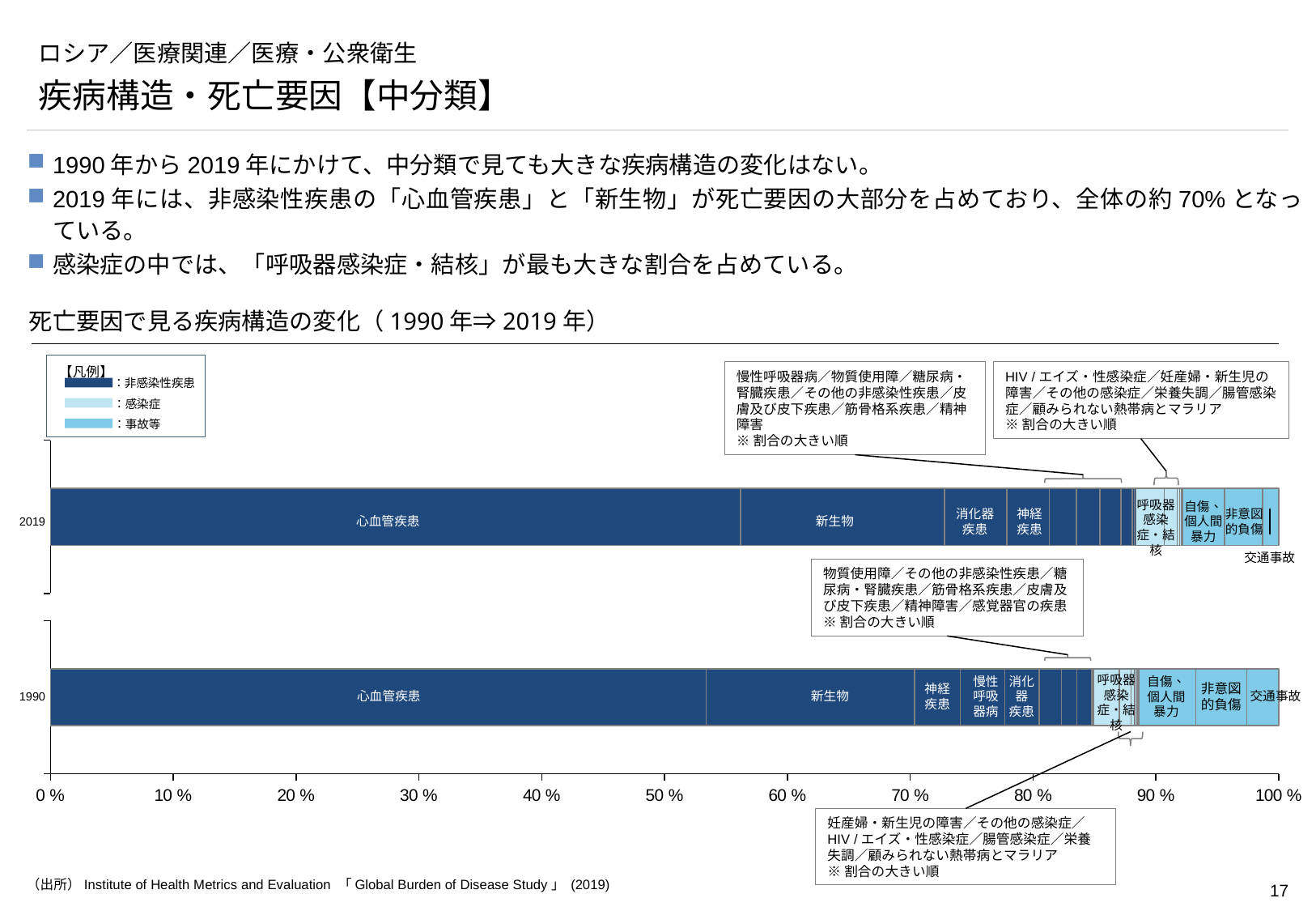
Which cause of death is the rightmost segment in the 1990 bar? 交通事故 How many bars (years) does the chart show? 2 Which cause of death has the largest segment in the 2019 bar? 心血管疾患 How many entries does the legend list? 3 What is the title of the chart? 死亡要因で見る疾病構造の変化（1990年⇒2019年） Which legend entry is shown in dark blue? 非感染性疾患 Is the share of 心血管疾患 in 2019 greater or less than 50%? greater Which cause of death has the largest segment in the 1990 bar? 心血管疾患 In the 1990 bar, which segment is larger, 新生物 or 消化器疾患? 新生物 What kind of chart is shown on the slide? Stacked bar chart In the 2019 bar, which segment is larger, 心血管疾患 or 新生物? 心血管疾患 Is the share of 心血管疾患 in 1990 greater or less than 60%? less